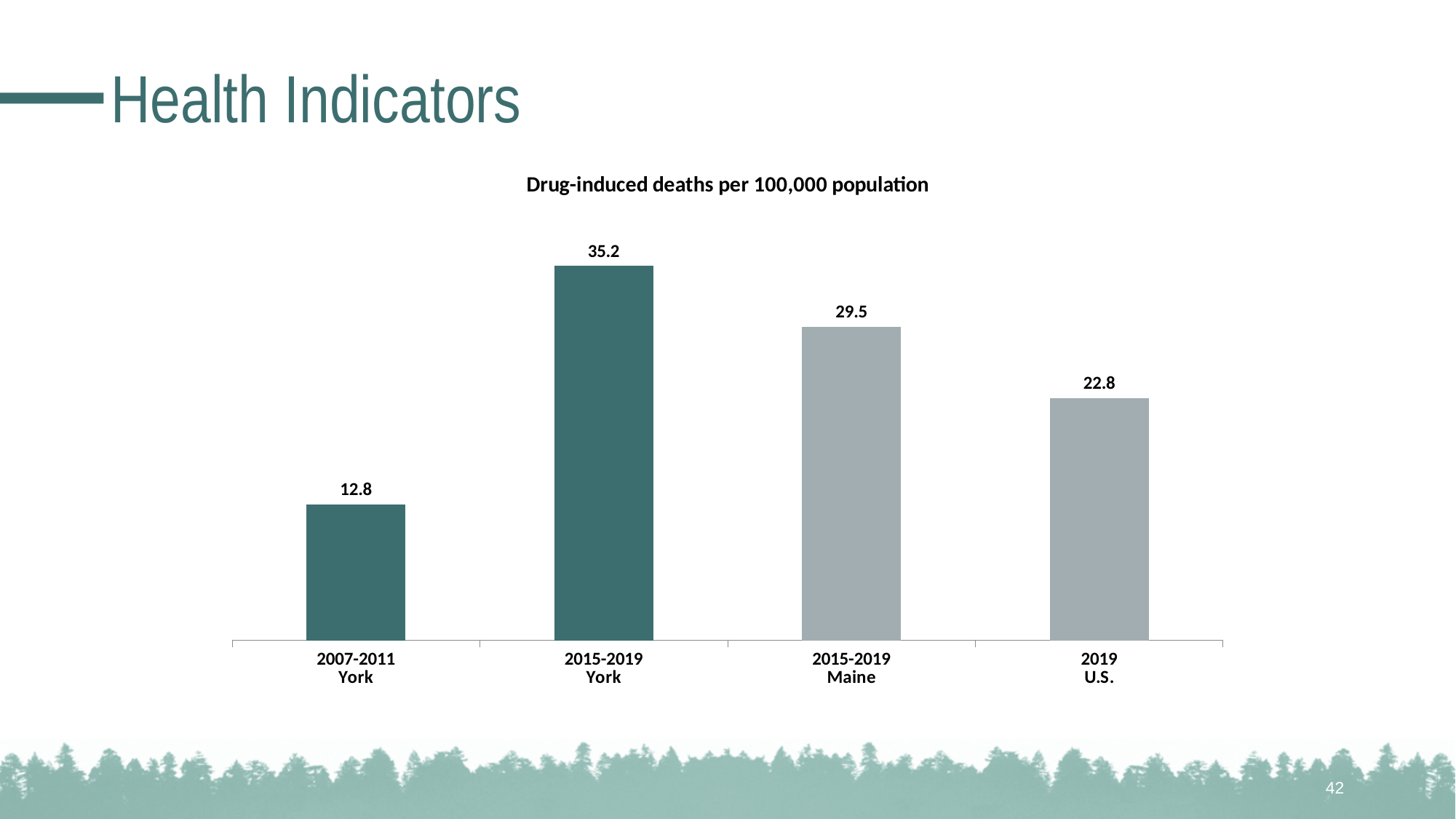
What is the value for 2019 U.S.? 22.8 Which category has the lowest value? 2007-2011 York What is the difference between the 2015-2019 York value and the 2007-2011 York value? 22.4 What is the value for 2007-2011 York? 12.8 What is the title of the chart? Drug-induced deaths per 100,000 population How many bars are shown in the chart? 4 Which category has the highest value? 2015-2019 York Which is larger, the value for 2015-2019 Maine or the value for 2019 U.S.? 2015-2019 Maine What kind of chart is shown on the slide? Bar chart What is the value for 2015-2019 York? 35.2 What is the value for 2015-2019 Maine? 29.5 What is the difference between the 2015-2019 York value and the 2015-2019 Maine value? 5.7